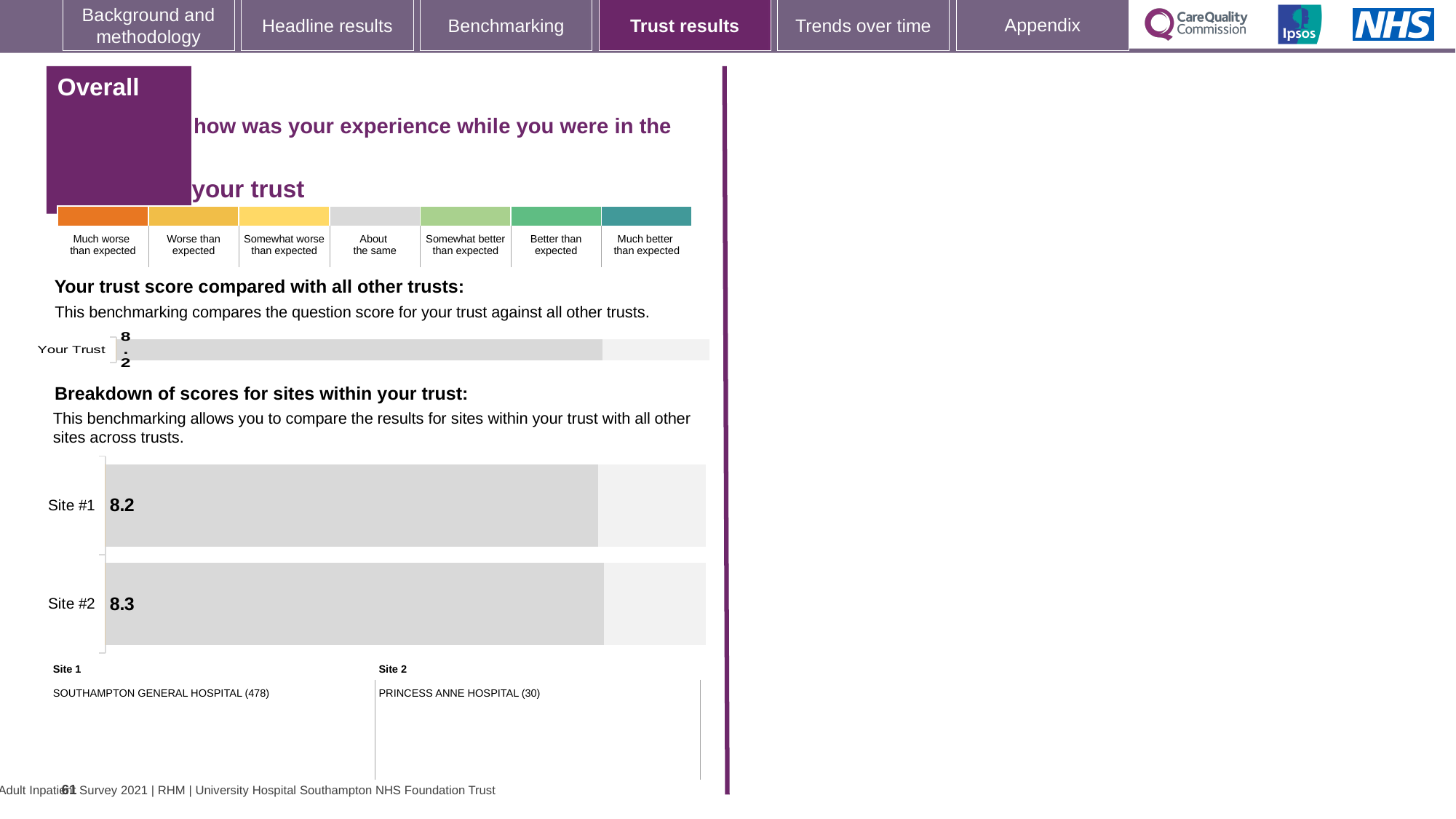
In the 'Breakdown of scores for sites within your trust' chart, is the score for Site #1 larger or smaller than the score for Site #2? smaller In the 'Breakdown of scores for sites within your trust' chart, which site has the lower score? Site #1 According to the key below the chart, which hospital is Site 2? PRINCESS ANNE HOSPITAL (30) In the 'Breakdown of scores for sites within your trust' chart, what is the difference between the scores for Site #2 and Site #1? 0.1 In the 'Breakdown of scores for sites within your trust' chart, what is the score for Site #1? 8.2 In the 'Breakdown of scores for sites within your trust' chart, what is the score for Site #2? 8.3 What kind of chart is the 'Breakdown of scores for sites within your trust' chart? bar chart In the 'Your trust score compared with all other trusts' chart, what is the score shown for Your Trust? 8.2 How many sites are shown in the 'Breakdown of scores for sites within your trust' chart? 2 In the 'Breakdown of scores for sites within your trust' chart, which site has the higher score? Site #2 According to the key below the chart, which hospital is Site 1? SOUTHAMPTON GENERAL HOSPITAL (478) How many categories are plotted in the 'Your trust score compared with all other trusts' chart? 1